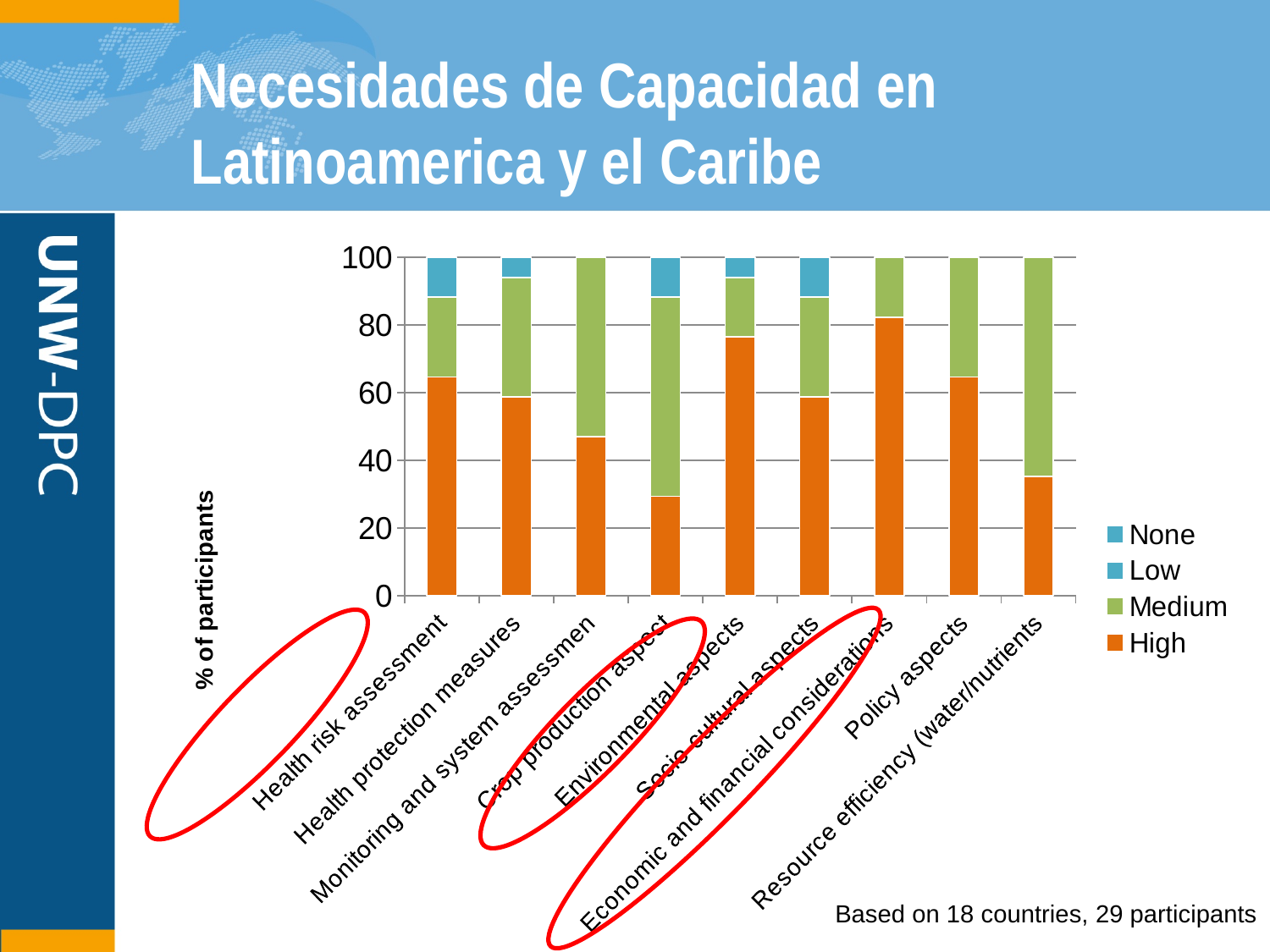
How many categories are plotted along the x axis? 9 What is the label on the y axis? % of participants How many series does the legend list? 4 What are the entries in the legend, from top to bottom? None, Low, Medium, High Is the High value for Health risk assessment greater or less than 60? greater Which has a larger High segment, Environmental aspects or Monitoring and system assessment? Environmental aspects What kind of chart is shown on the slide? Stacked bar chart Which has a larger High segment, Policy aspects or Resource efficiency (water/nutrients)? Policy aspects Which category has the largest High segment? Economic and financial considerations Which category has the smallest High segment? Crop production aspect Is the High value for Environmental aspects greater or less than 60? greater Is the High value for Crop production aspect greater or less than 40? less